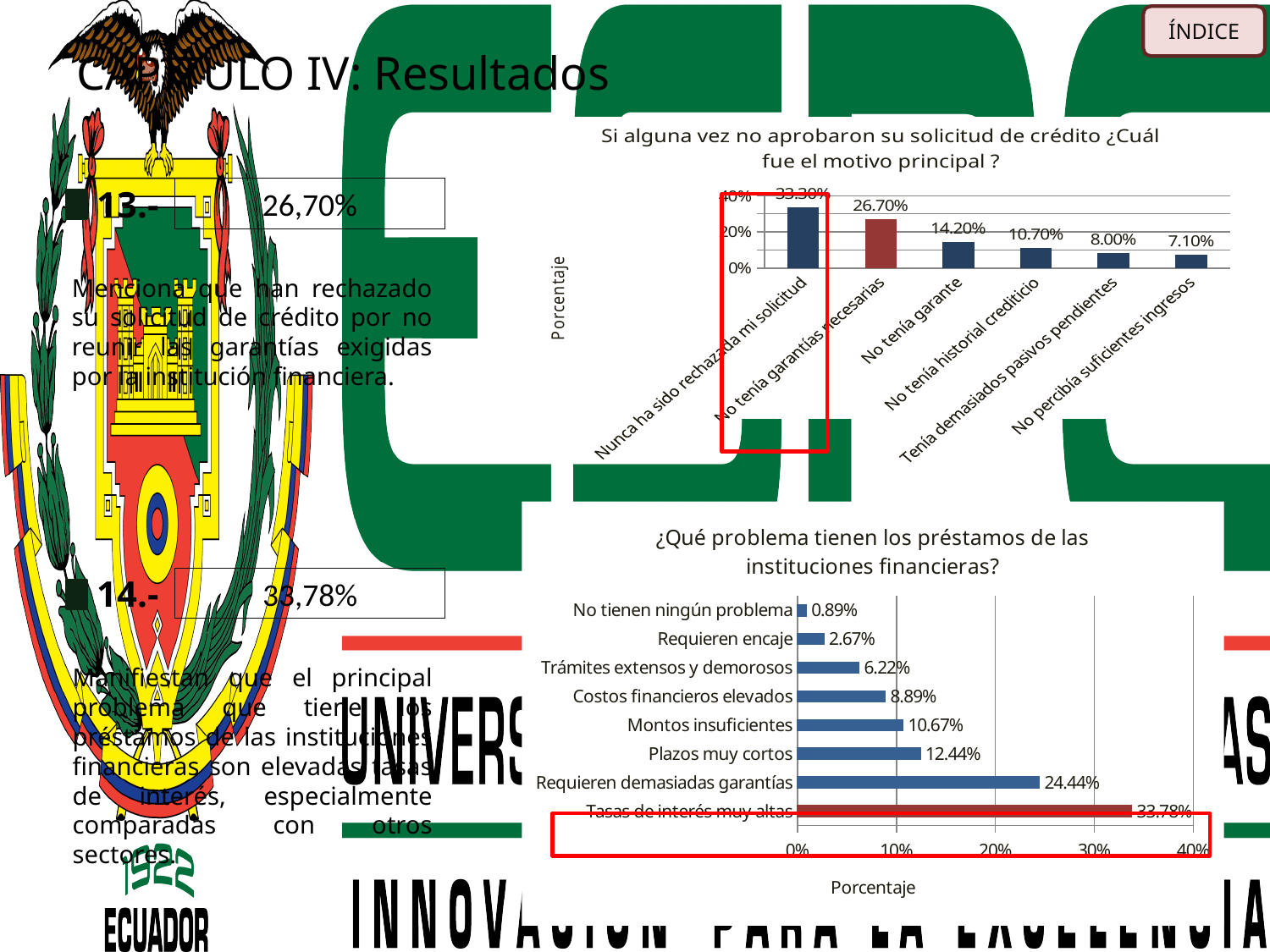
In the bottom chart '¿Qué problema tienen los préstamos de las instituciones financieras?', which category has the highest value? Tasas de interés muy altas In the bottom chart '¿Qué problema tienen los préstamos de las instituciones financieras?', how many categories are shown? 8 In the top chart 'Si alguna vez no aprobaron su solicitud de crédito', what is the value for 'No tenía garante'? 14.20% In the top chart 'Si alguna vez no aprobaron su solicitud de crédito', what is the value for 'No tenía garantías necesarias'? 26.70% In the bottom chart '¿Qué problema tienen los préstamos de las instituciones financieras?', what is the value for 'Requieren demasiadas garantías'? 24.44% In the top chart 'Si alguna vez no aprobaron su solicitud de crédito', what is the difference between 'No tenía historial crediticio' and 'Tenía demasiados pasivos pendientes'? 2.70% In the top chart 'Si alguna vez no aprobaron su solicitud de crédito', which category has the lowest value? No percibía suficientes ingresos In the bottom chart '¿Qué problema tienen los préstamos de las instituciones financieras?', which is larger: 'Montos insuficientes' or 'Costos financieros elevados'? Montos insuficientes In the bottom chart '¿Qué problema tienen los préstamos de las instituciones financieras?', which category has the lowest value? No tienen ningún problema In the bottom chart '¿Qué problema tienen los préstamos de las instituciones financieras?', what is the value for 'Plazos muy cortos'? 12.44% In the top chart 'Si alguna vez no aprobaron su solicitud de crédito', how many categories are shown? 6 In the top chart 'Si alguna vez no aprobaron su solicitud de crédito', what type of chart is used? Bar chart